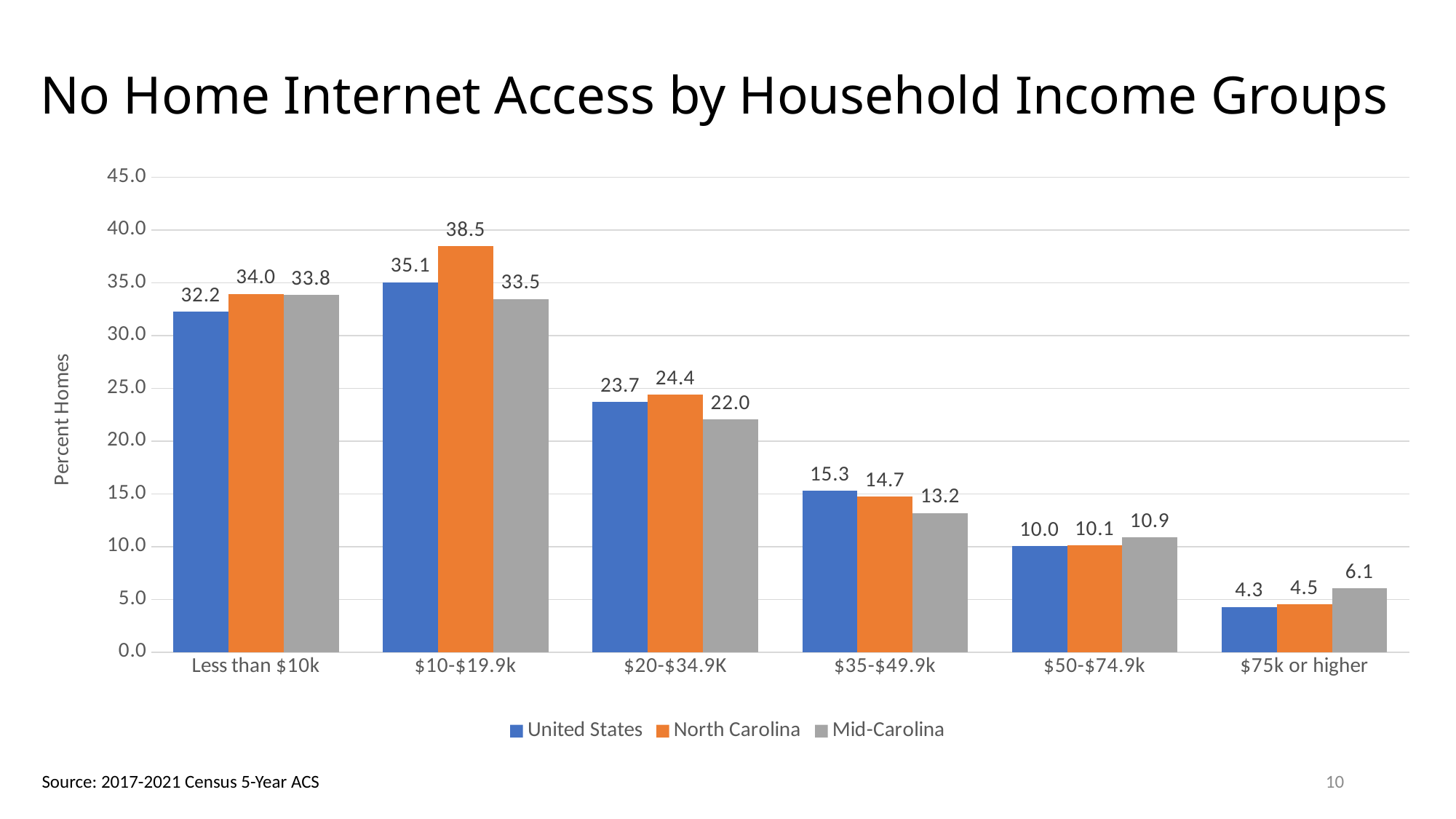
What kind of chart is shown on the slide? bar chart How many series does the legend list? 3 What is the value for Mid-Carolina in the $75k or higher income group? 6.1 Do the Mid-Carolina values generally rise or fall from the $10-$19.9k group to the $75k or higher group? fall Which income group has the lowest value for United States? $75k or higher What is the value for United States in the $20-$34.9K income group? 23.7 In the $35-$49.9k income group, which is larger: the United States value or the Mid-Carolina value? United States What is the difference between the North Carolina and Mid-Carolina values in the $10-$19.9k income group? 5.0 Which income group has the highest value for North Carolina? $10-$19.9k What is the value for North Carolina in the $10-$19.9k income group? 38.5 How many income groups are shown on the x axis? 6 Is the value for Mid-Carolina in the $20-$34.9K income group greater or less than 25.0? less